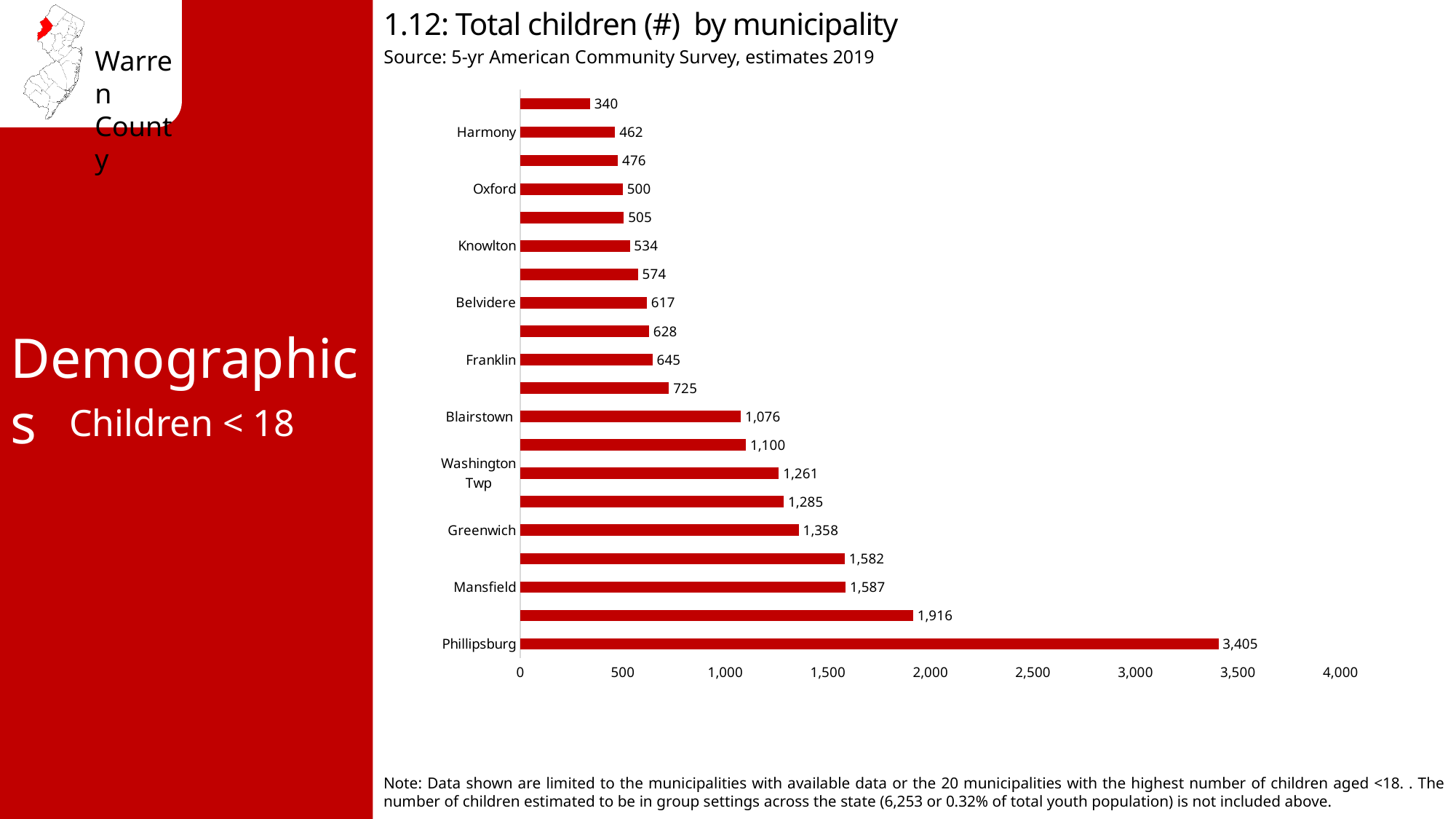
What kind of chart is shown on the slide? Bar chart What is the smallest value shown on the chart? 340 How many bars are plotted on the chart? 20 What is the value for Harmony? 462 Which municipality has the highest number of children? Phillipsburg Which has a larger value, Greenwich or Washington Twp? Greenwich Is the value for Phillipsburg greater or less than 3,000? greater What is the value for Washington Twp? 1,261 What is the value for Phillipsburg? 3,405 How many children are shown for Mansfield? 1,587 What is the difference between the values for Phillipsburg and Mansfield? 1,818 What is the difference between the values for Greenwich and Blairstown? 282